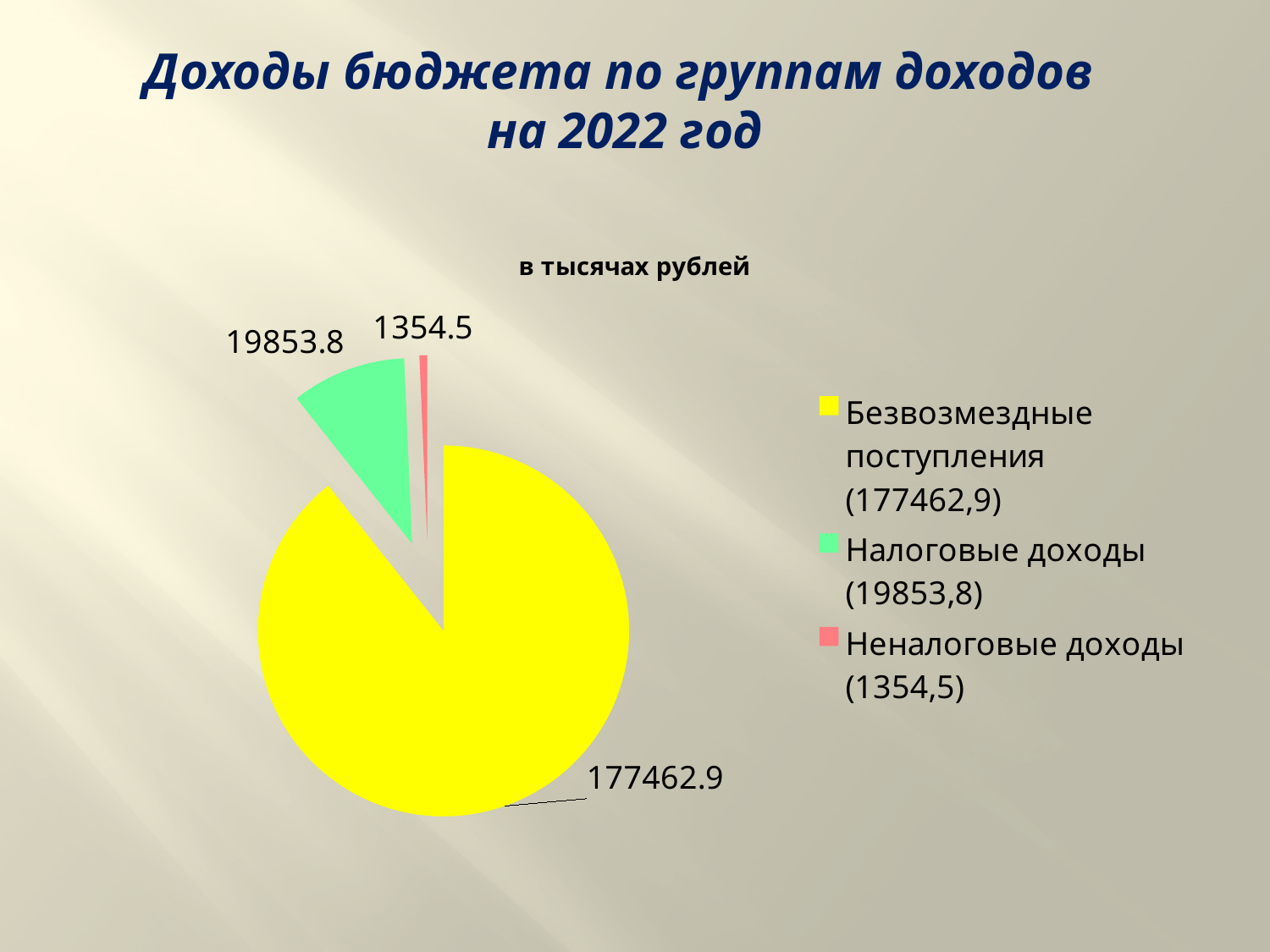
What is the value for Налоговые доходы? 19853.8 What is the value for Неналоговые доходы? 1354.5 What unit is stated in the chart title? в тысячах рублей What is the difference between Налоговые доходы and Неналоговые доходы? 18499.3 Which is larger, Налоговые доходы or Неналоговые доходы? Налоговые доходы What type of chart is shown on the slide? pie chart Which category has the largest slice of the pie? Безвозмездные поступления How many slices does the pie chart have? 3 Which category has the smallest slice of the pie? Неналоговые доходы What is the difference between Безвозмездные поступления and Налоговые доходы? 157609.1 How many entries does the legend list? 3 What is the value for Безвозмездные поступления? 177462.9